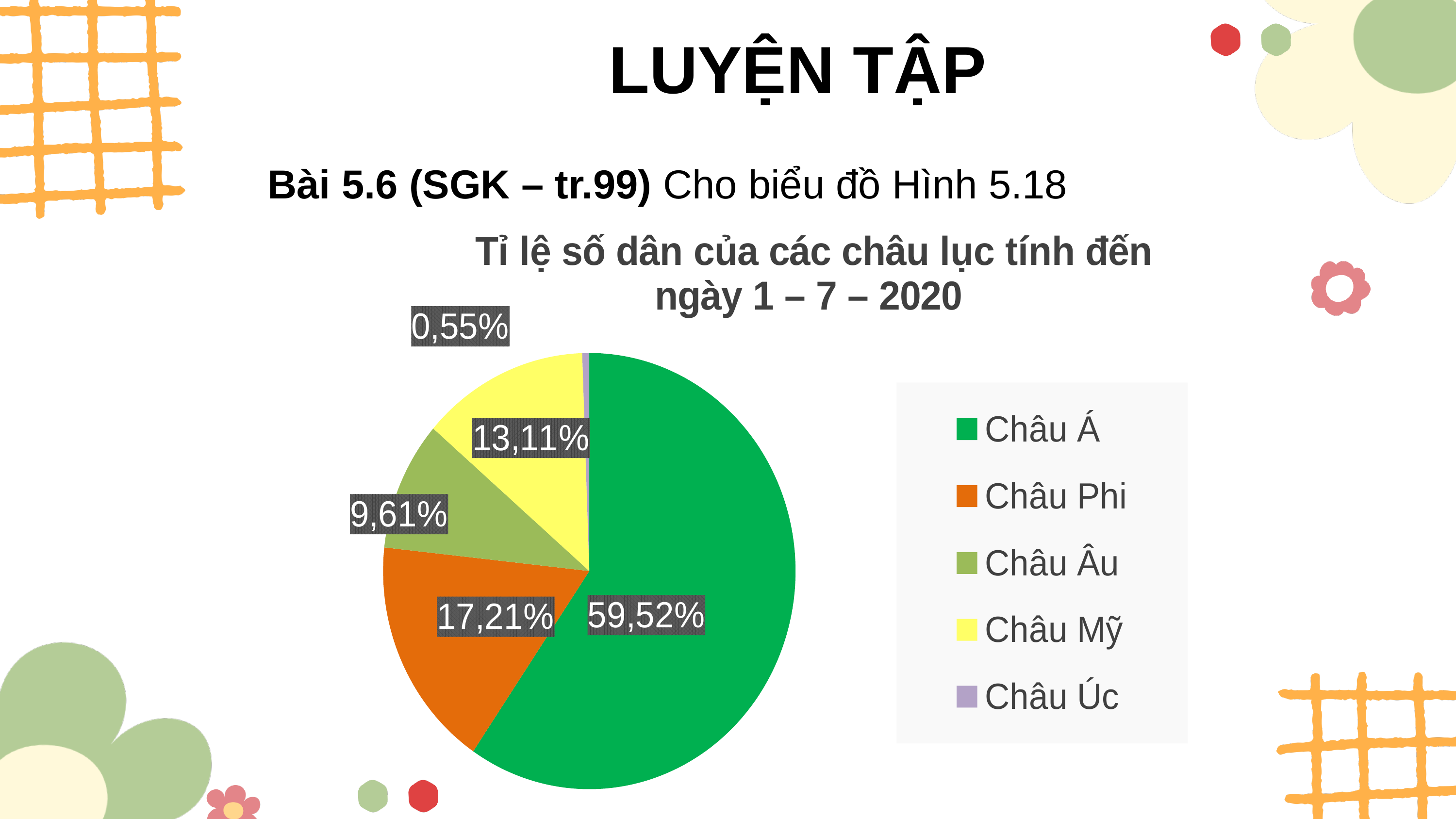
What is the chart's title? Tỉ lệ số dân của các châu lục tính đến ngày 1 – 7 – 2020 Which continent has the smallest share of the pie? Châu Úc What percentage of the pie is Châu Phi? 17,21% Which is larger, the share for Châu Phi or the share for Châu Mỹ? Châu Phi How many slices does the pie chart have? 5 What is the difference between the shares of Châu Á and Châu Phi? 42,31% What percentage of the pie is Châu Úc? 0,55% What percentage of the pie is Châu Á? 59,52% Which continent has the largest share of the pie? Châu Á What percentage of the pie is Châu Mỹ? 13,11% What kind of chart is shown on the slide? Pie chart What percentage of the pie is Châu Âu? 9,61%